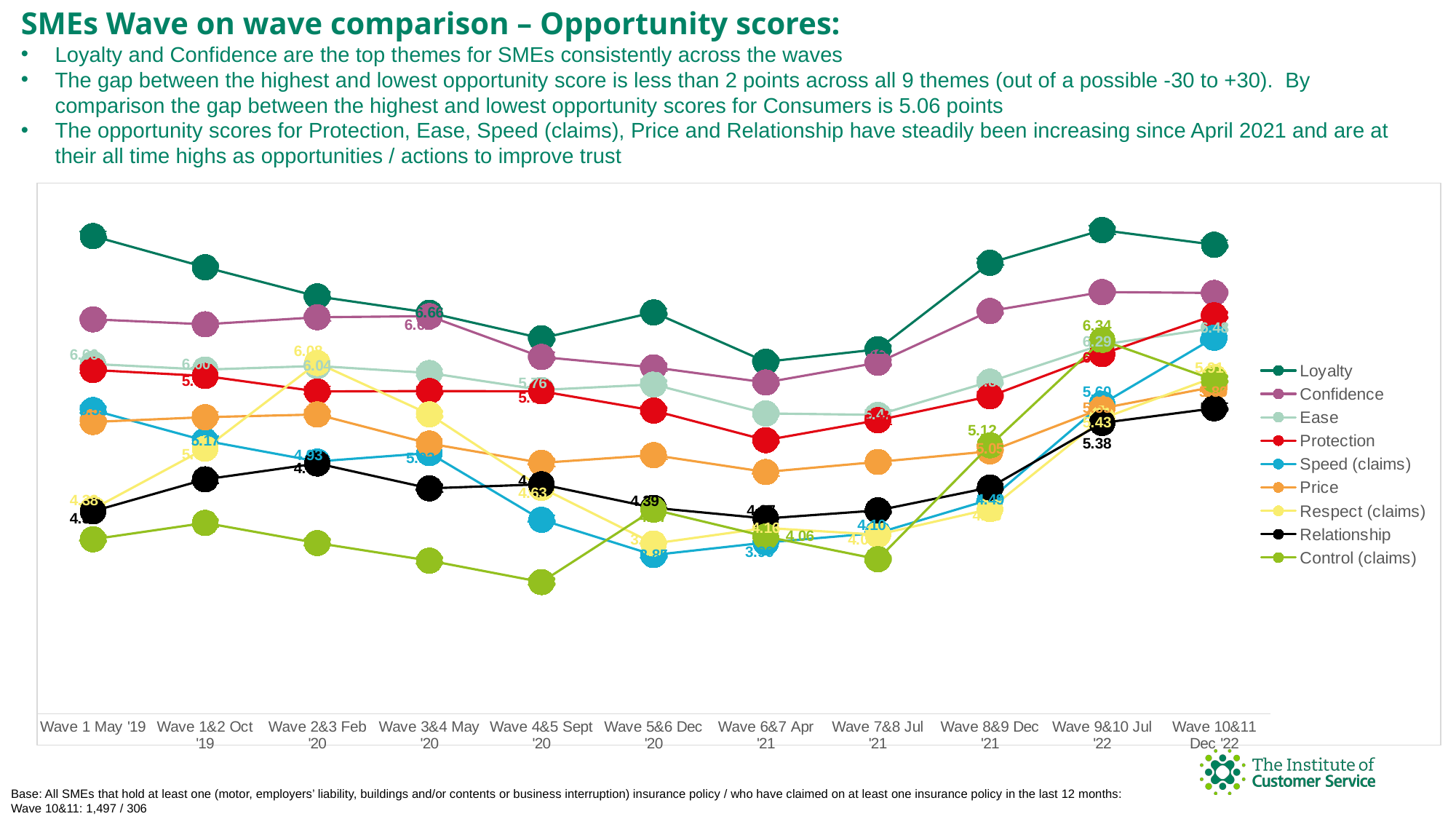
What kind of chart is shown on the slide? Line chart What is the Relationship opportunity score at Wave 9&10 Jul '22? 5.38 Does the Loyalty line rise or fall from Wave 6&7 Apr '21 to Wave 9&10 Jul '22? Rise At Wave 10&11 Dec '22, which is higher: Loyalty or Confidence? Loyalty Which series is listed first in the legend? Loyalty How many waves are plotted along the x axis? 11 What is the Control (claims) opportunity score at Wave 9&10 Jul '22? 6.34 At Wave 9&10 Jul '22, how much higher is Control (claims) than Relationship? 0.96 Which theme has the highest opportunity score at Wave 1 May '19? Loyalty Which theme has the lowest opportunity score at Wave 4&5 Sept '20? Control (claims) How many series does the legend list? 9